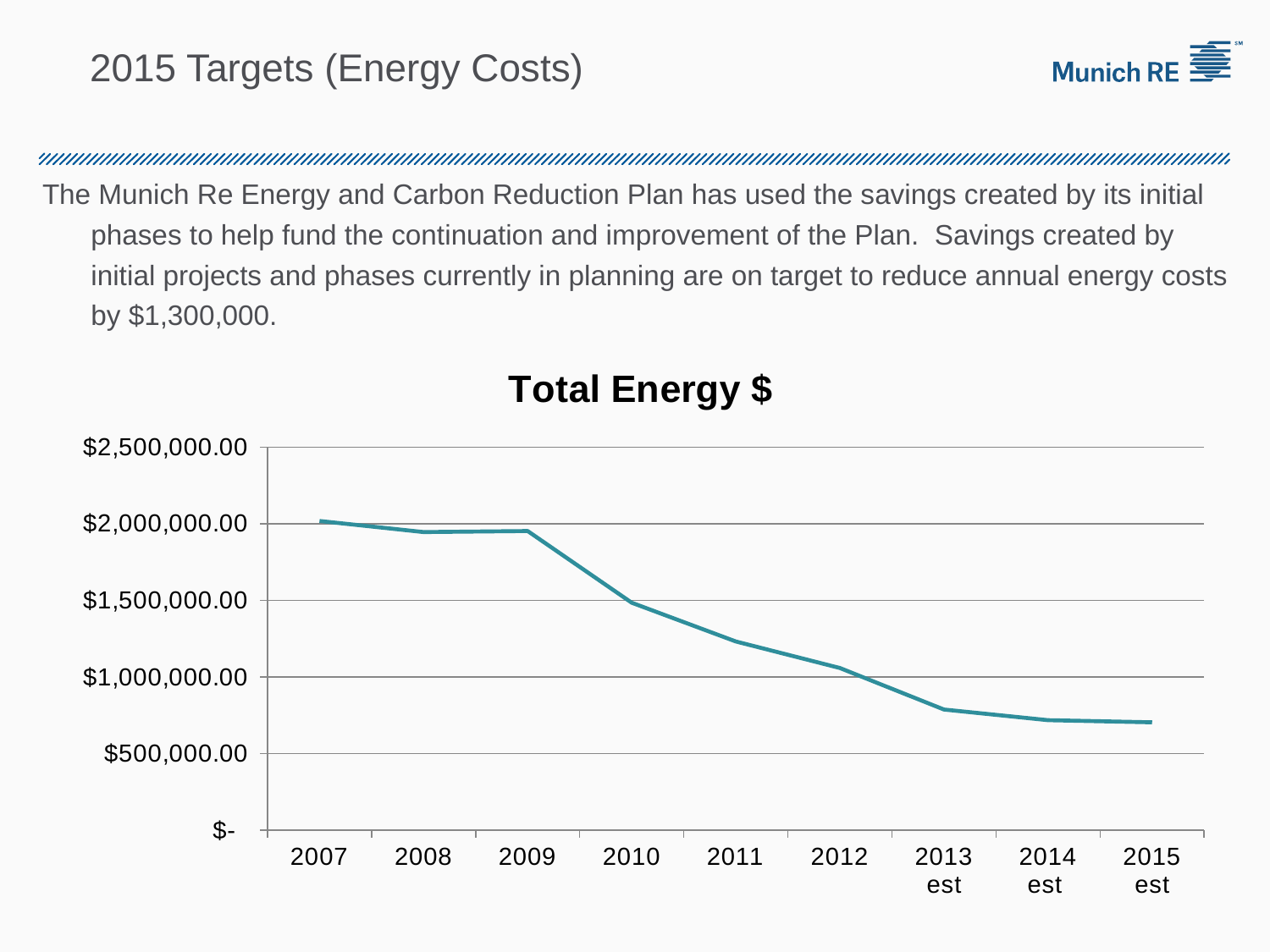
Is the value for 2009 greater or less than $1,500,000.00? greater What is the title of the chart? Total Energy $ How many years (data points) are plotted along the x axis of the chart? 9 Which year has the highest Total Energy $ value? 2007 What kind of chart is shown on the slide? line chart Is the value for 2015 est greater or less than $500,000.00? greater Is the value for 2008 greater or less than $2,000,000.00? less Do the values in the chart rise or fall from 2007 to 2015 est? fall Which is larger, the value for 2009 or the value for 2013 est? 2009 Which is larger, the value for 2010 or the value for 2012? 2010